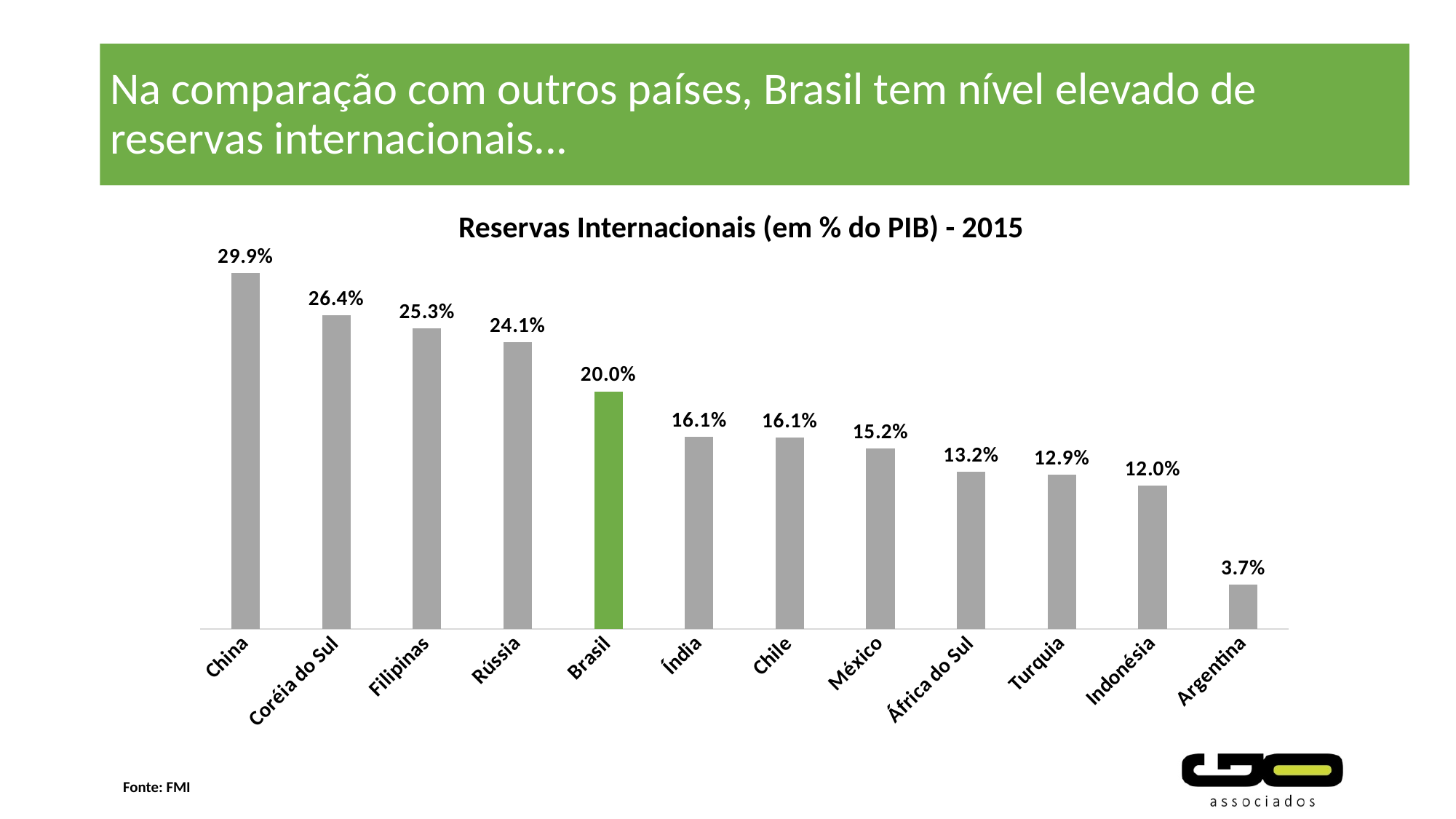
What is the difference between the values for China and Brasil? 9.9% What is the value for Argentina? 3.7% What kind of chart is shown on the slide? Bar chart What is the difference between the values for Coréia do Sul and Filipinas? 1.1% Which country has the highest international reserves as % of GDP? China Which is larger, the value for México or the value for Turquia? México What is the value for Rússia? 24.1% What is the title of the chart? Reservas Internacionais (em % do PIB) - 2015 Do the values rise or fall from left to right along the x axis? Fall How many countries are shown in the chart? 12 What is the value for Brasil in the chart? 20.0% Which country has the lowest value in the chart? Argentina